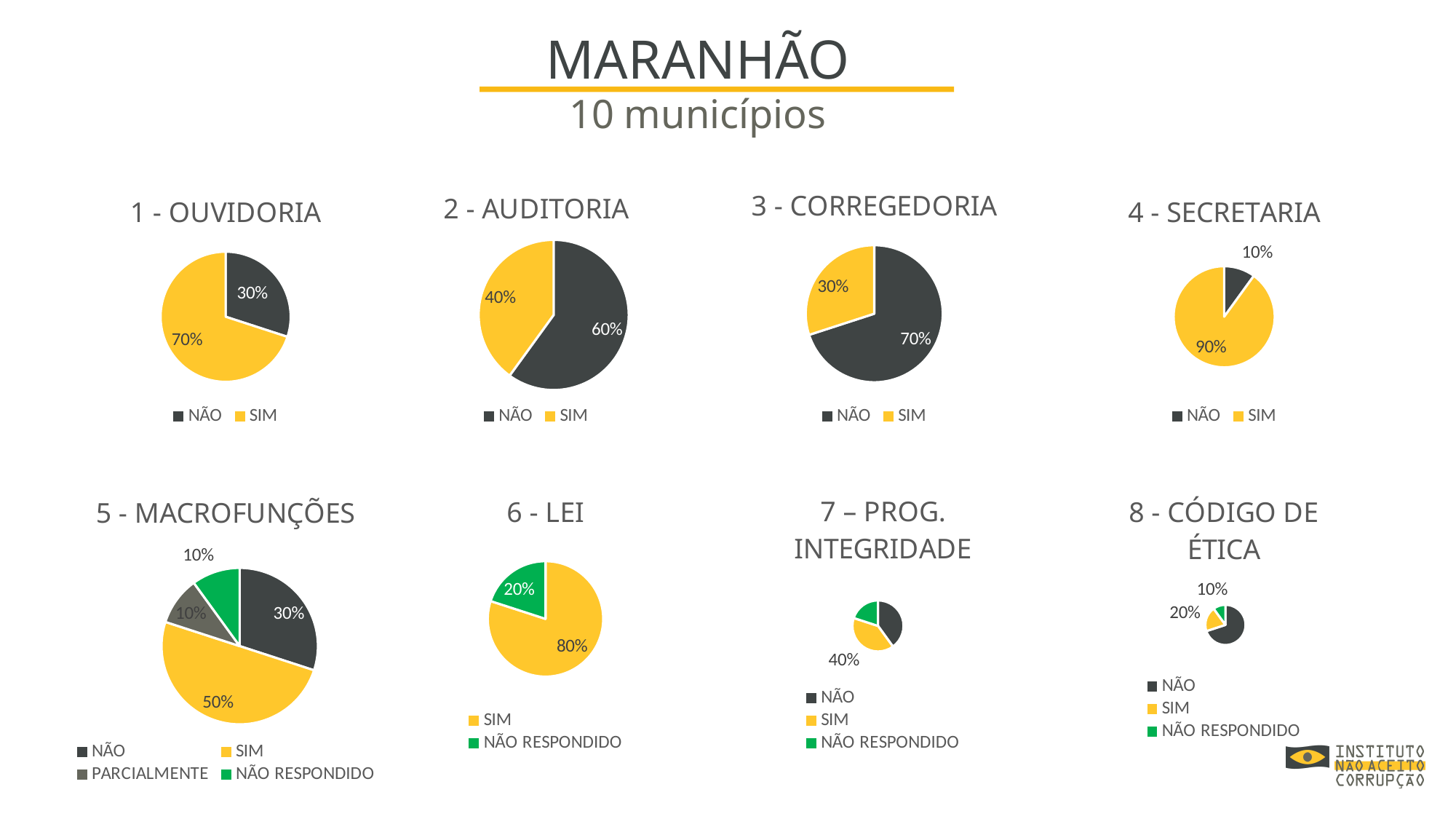
In the "1 - OUVIDORIA" pie chart, what share is SIM? 70% In the "3 - CORREGEDORIA" pie chart, which category has the largest slice? NÃO How many categories does the legend of the "5 - MACROFUNÇÕES" pie chart list? 4 In the "6 - LEI" pie chart, what share is NÃO RESPONDIDO? 20% In the "7 – PROG. INTEGRIDADE" pie chart, what share is SIM? 40% In the "2 - AUDITORIA" pie chart, what share is NÃO? 60% In the "8 - CÓDIGO DE ÉTICA" pie chart, which category has the largest slice? NÃO In the "4 - SECRETARIA" pie chart, what is the difference between the SIM and NÃO shares? 80% What type of chart is used for "1 - OUVIDORIA"? Pie chart In the "4 - SECRETARIA" pie chart, what share is NÃO? 10% In the "2 - AUDITORIA" pie chart, which is larger, NÃO or SIM? NÃO In the "5 - MACROFUNÇÕES" pie chart, what share is PARCIALMENTE? 10%